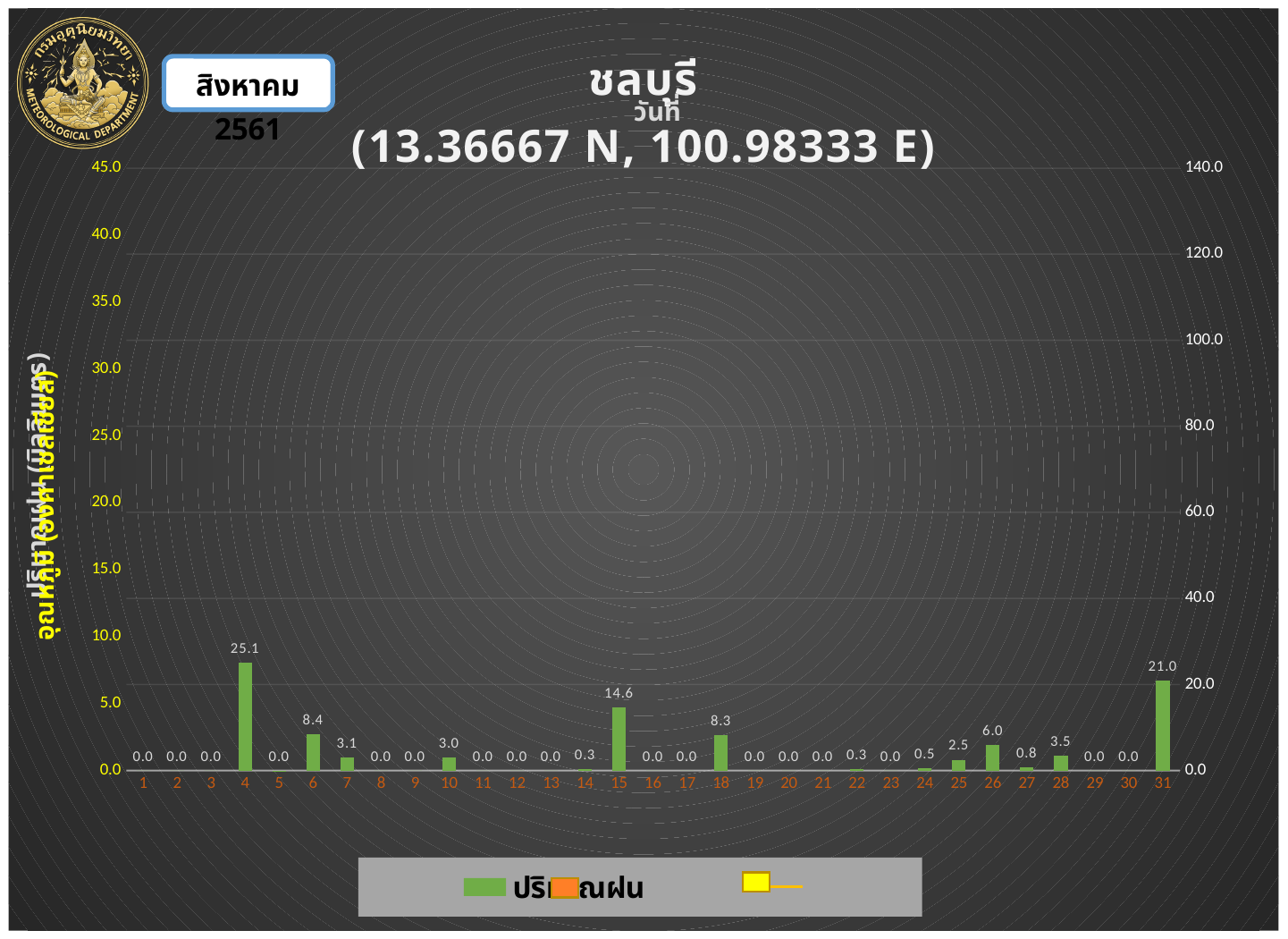
How many days are shown on the x axis? 31 What is the label of the green series in the legend? ปริมาณฝน Which day has the highest value? 4 Which is larger, the value for day 6 or the value for day 26? day 6 Which is larger, the value for day 15 or the value for day 18? day 15 What is the value for day 26? 6.0 What is the value for day 4? 25.1 What is the difference between the values for day 15 and day 18? 6.3 What is the value for day 31? 21.0 What is the difference between the values for day 4 and day 31? 4.1 What is the value for day 15? 14.6 What kind of chart is this? bar chart